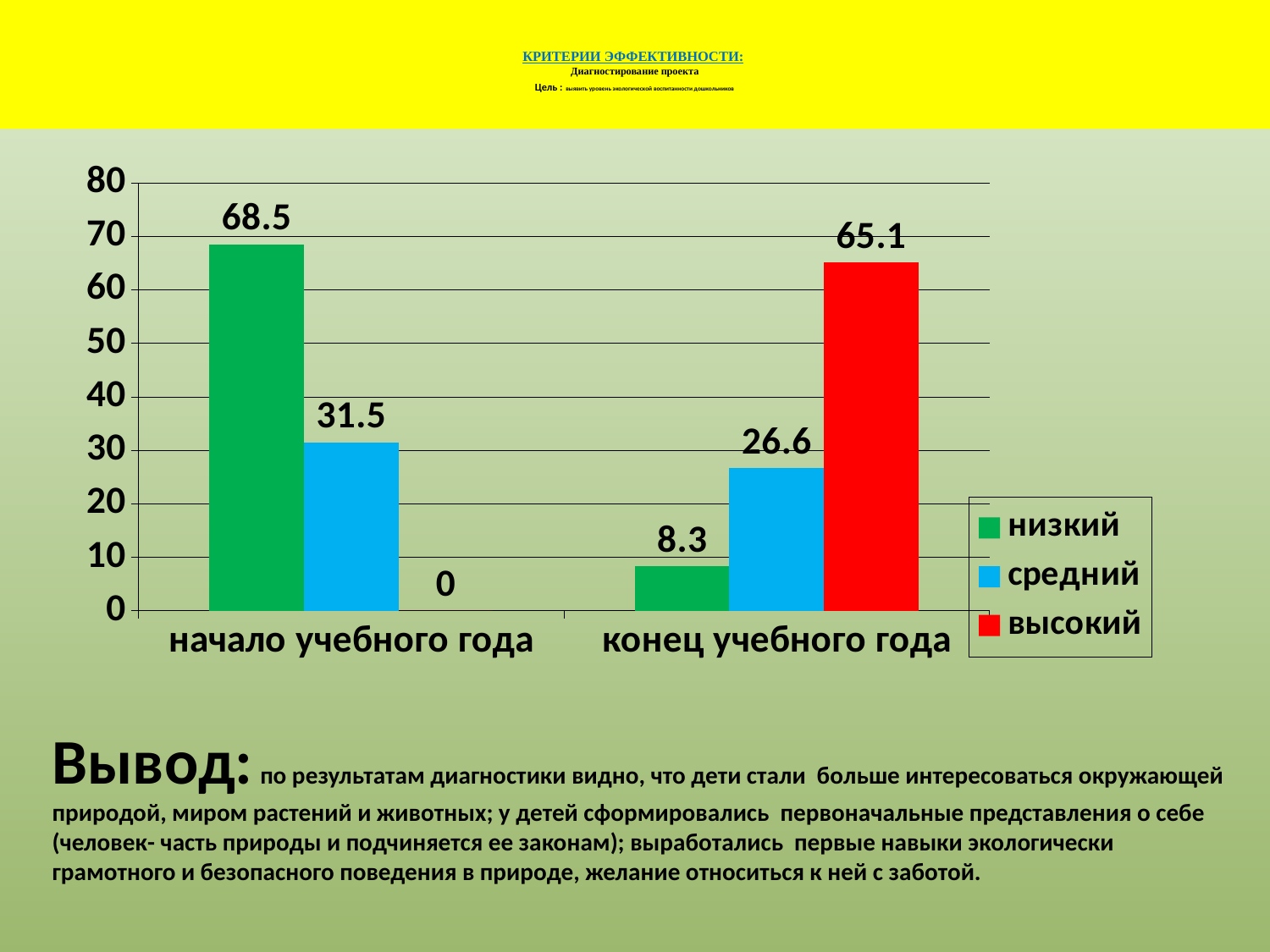
What kind of chart is shown on the slide? bar chart What is the difference between the низкий values at начало учебного года and конец учебного года? 60.2 What colour represents the средний series? blue How many categories are shown on the x axis? 2 What is the value for высокий at конец учебного года? 65.1 Which series has the lowest value at начало учебного года? высокий What is the value for средний at начало учебного года? 31.5 What is the value for высокий at начало учебного года? 0 Which series has the highest value at конец учебного года? высокий How many series does the legend list? 3 What is the value for низкий at начало учебного года? 68.5 Which is larger: средний at начало учебного года or средний at конец учебного года? средний at начало учебного года